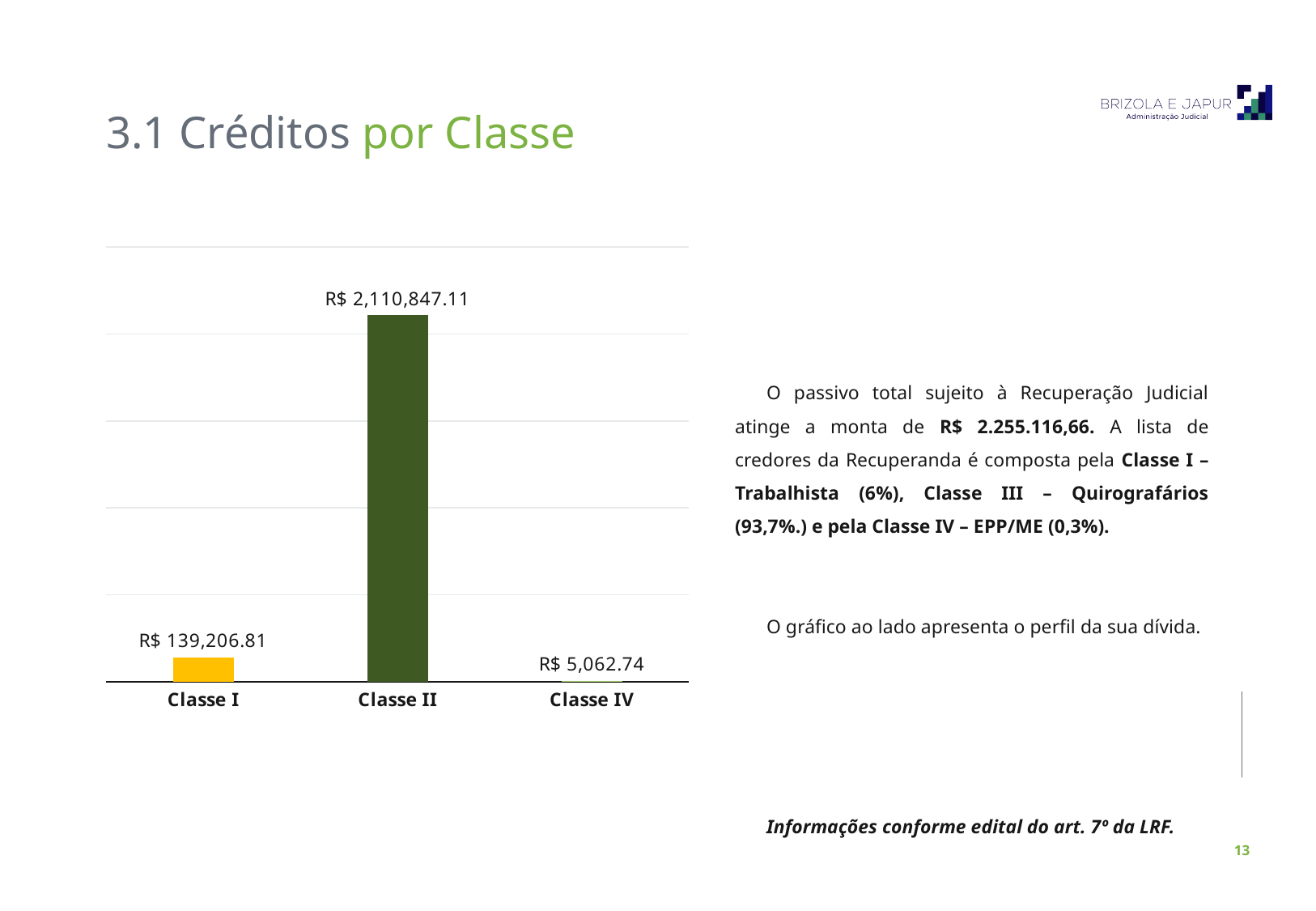
What is the title of the slide containing the chart? 3.1 Créditos por Classe What is the difference between the values for Classe II and Classe I? R$ 1,971,640.30 Which is larger, the value for Classe I or the value for Classe IV? Classe I Which class has the lowest value? Classe IV What is the value for Classe IV? R$ 5,062.74 What is the value for Classe I? R$ 139,206.81 What is the value for Classe II? R$ 2,110,847.11 Which class has the highest value? Classe II What kind of chart is shown on the slide? Bar chart How many classes are shown in the chart? 3 What is the difference between the values for Classe I and Classe IV? R$ 134,144.07 What colour is the bar for Classe I? Yellow